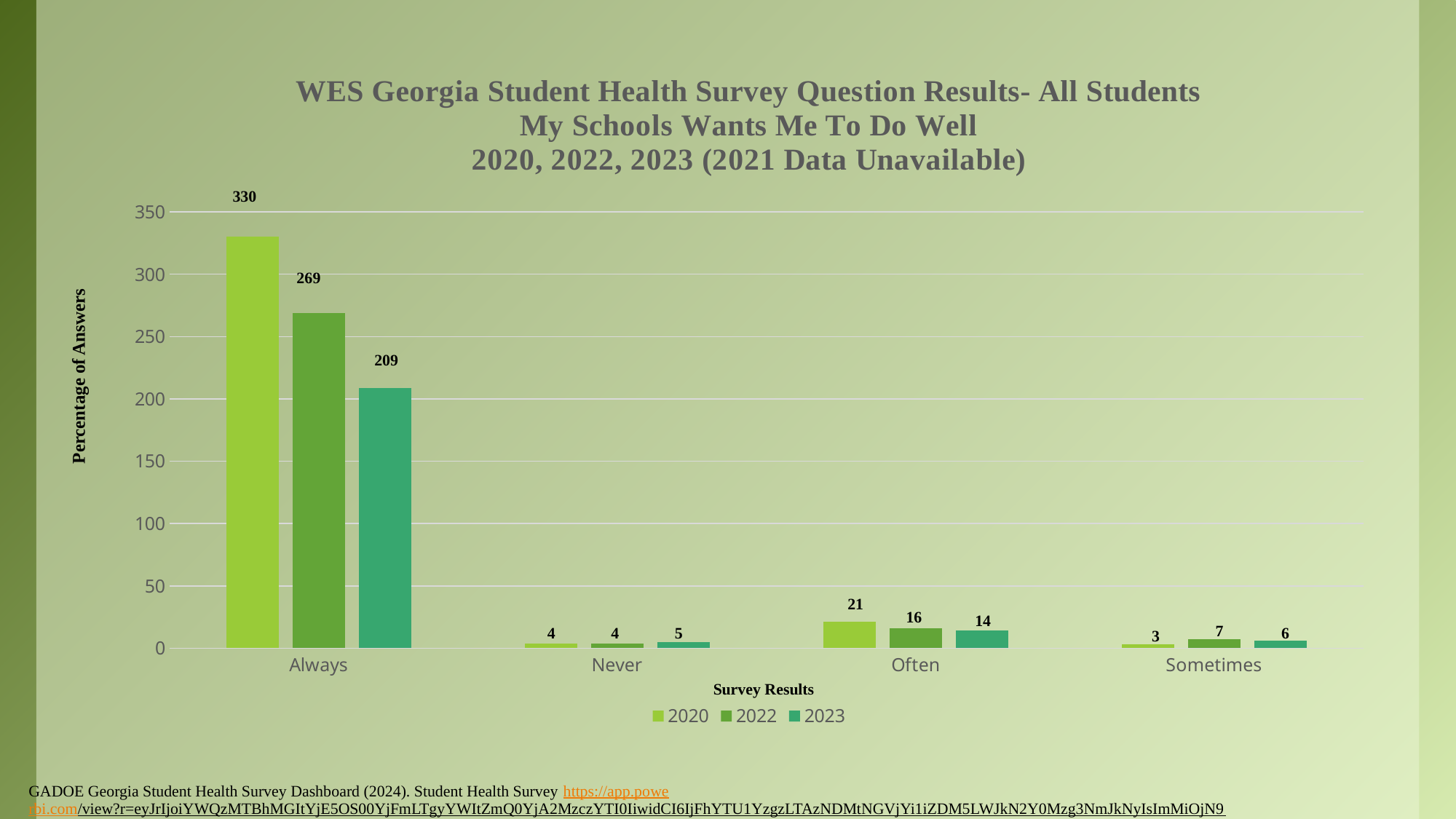
How many categories are shown on the x axis? 4 What kind of chart is shown on the slide? bar chart What is the value for 2023 in the Often category? 14 What is the value for 2020 in the Always category? 330 Which category has the highest value for the 2022 series? Always Which is larger in the Often category, the 2020 value or the 2022 value? 2020 What is the value for 2022 in the Sometimes category? 7 Which category has the lowest value for the 2020 series? Sometimes What is the difference between the 2020 and 2023 values in the Always category? 121 What is the label of the y axis? Percentage of Answers How many series does the legend list? 3 Is the value for 2022 in the Always category greater or less than 250? greater